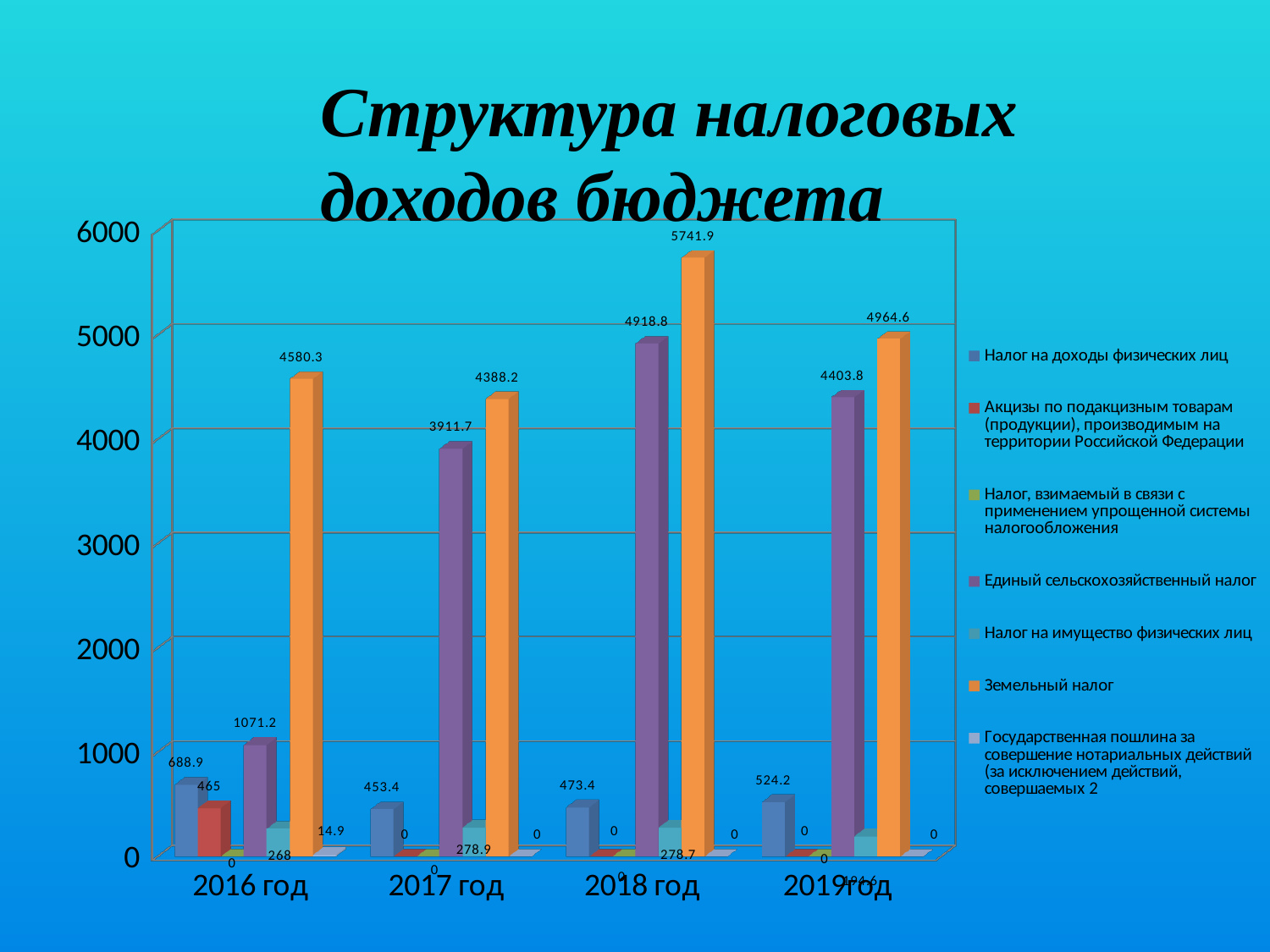
What is the value of Земельный налог for 2018 год? 5741.9 In which year is Налог на доходы физических лиц the lowest? 2017 год How many years are shown on the x axis? 4 What is the difference between Земельный налог in 2018 год and in 2017 год? 1353.7 What type of chart is shown on the slide? Bar chart What is the difference between Единый сельскохозяйственный налог in 2018 год and in 2016 год? 3847.6 What is the value of Акцизы по подакцизным товарам for 2016 год? 465 In which year is Земельный налог the highest? 2018 год What is the value of Налог на доходы физических лиц for 2016 год? 688.9 How many series does the legend list? 7 In 2019 год, which is larger: Единый сельскохозяйственный налог or Земельный налог? Земельный налог What is the value of Единый сельскохозяйственный налог for 2017 год? 3911.7